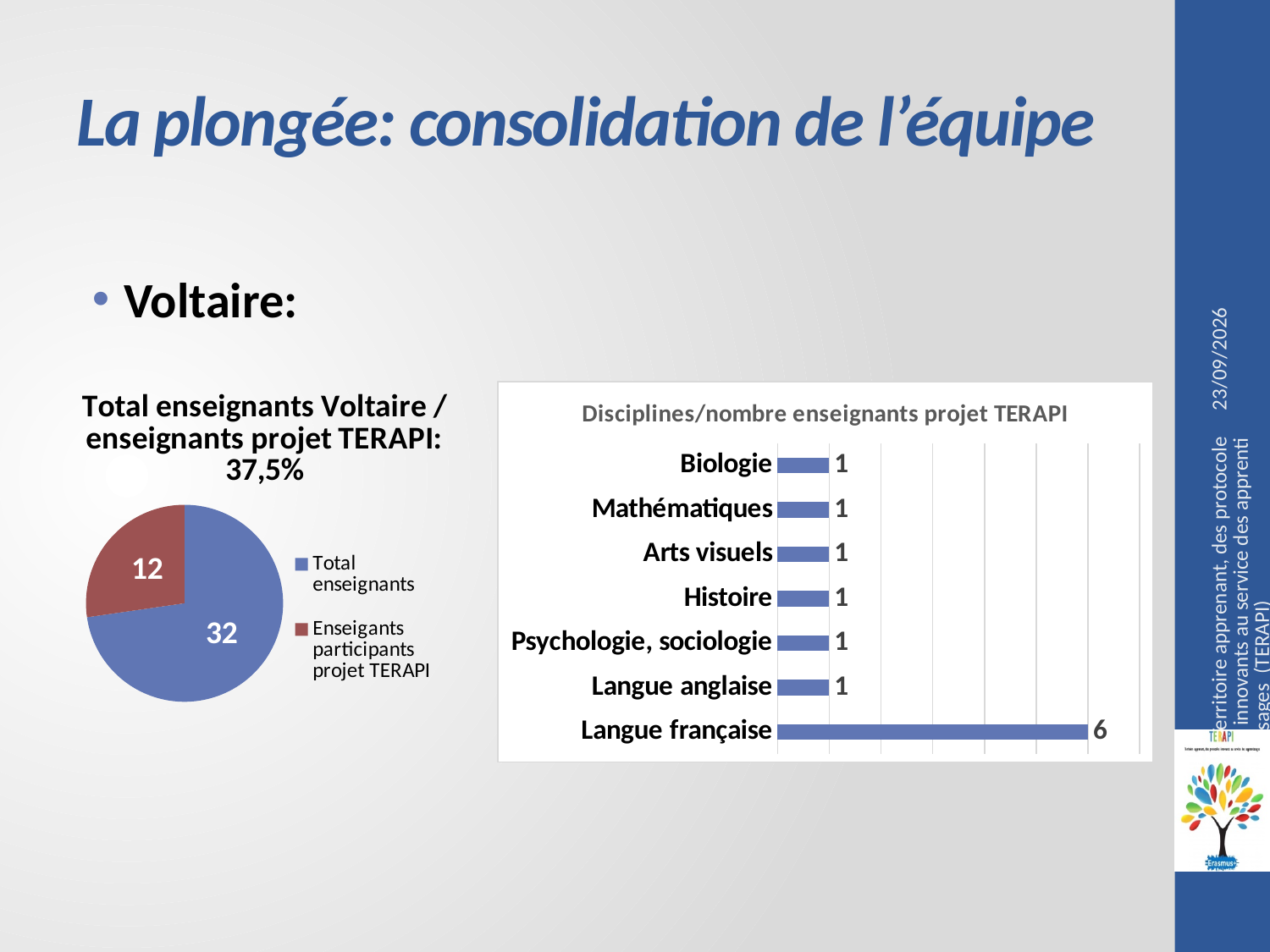
In the chart 'Disciplines/nombre enseignants projet TERAPI', which is larger: the value for 'Langue française' or the value for 'Biologie'? Langue française What percentage is shown in the title of the pie chart on the left? 37,5% In the chart 'Disciplines/nombre enseignants projet TERAPI', what is the value for 'Histoire'? 1 In the chart 'Disciplines/nombre enseignants projet TERAPI', what is the value for 'Langue française'? 6 In the pie chart on the left, what is the value for 'Total enseignants'? 32 In the chart 'Disciplines/nombre enseignants projet TERAPI', which discipline has the highest value? Langue française In the chart 'Disciplines/nombre enseignants projet TERAPI', what is the difference between the values for 'Langue française' and 'Langue anglaise'? 5 In the chart 'Disciplines/nombre enseignants projet TERAPI', how many disciplines are shown? 7 In the pie chart on the left, what is the value for 'Enseignants participants projet TERAPI'? 12 In the pie chart on the left, what is the difference between the 'Total enseignants' value and the 'Enseignants participants projet TERAPI' value? 20 In the pie chart on the left, how many entries does the legend list? 2 What kind of chart is 'Disciplines/nombre enseignants projet TERAPI'? Bar chart